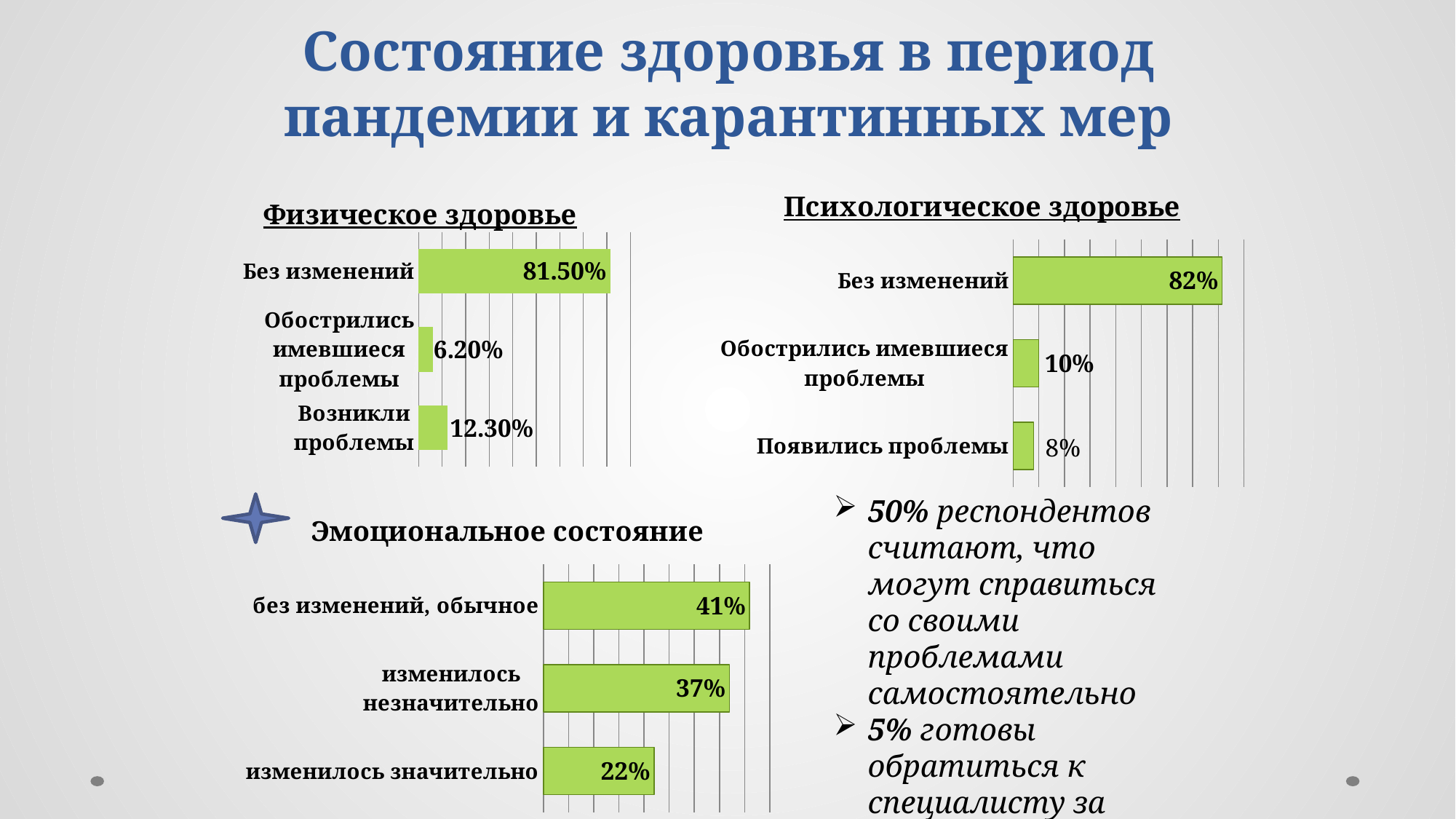
How many categories does the "Эмоциональное состояние" chart show? 3 In the "Физическое здоровье" chart, what is the value for "Без изменений"? 81.50% In the "Психологическое здоровье" chart, what is the difference between "Без изменений" and "Появились проблемы"? 74% In the "Эмоциональное состояние" chart, what is the value for "изменилось незначительно"? 37% In the "Физическое здоровье" chart, what is the difference between "Возникли проблемы" and "Обострились имевшиеся проблемы"? 6.10% In the "Психологическое здоровье" chart, which category has the highest value? Без изменений In the "Эмоциональное состояние" chart, which category has the lowest value? изменилось значительно In the "Физическое здоровье" chart, which category has the lowest value? Обострились имевшиеся проблемы In the "Физическое здоровье" chart, what is the value for "Возникли проблемы"? 12.30% In the "Психологическое здоровье" chart, which is larger: "Обострились имевшиеся проблемы" or "Появились проблемы"? Обострились имевшиеся проблемы What type of chart is the "Физическое здоровье" chart? Bar chart In the "Психологическое здоровье" chart, what is the value for "Обострились имевшиеся проблемы"? 10%